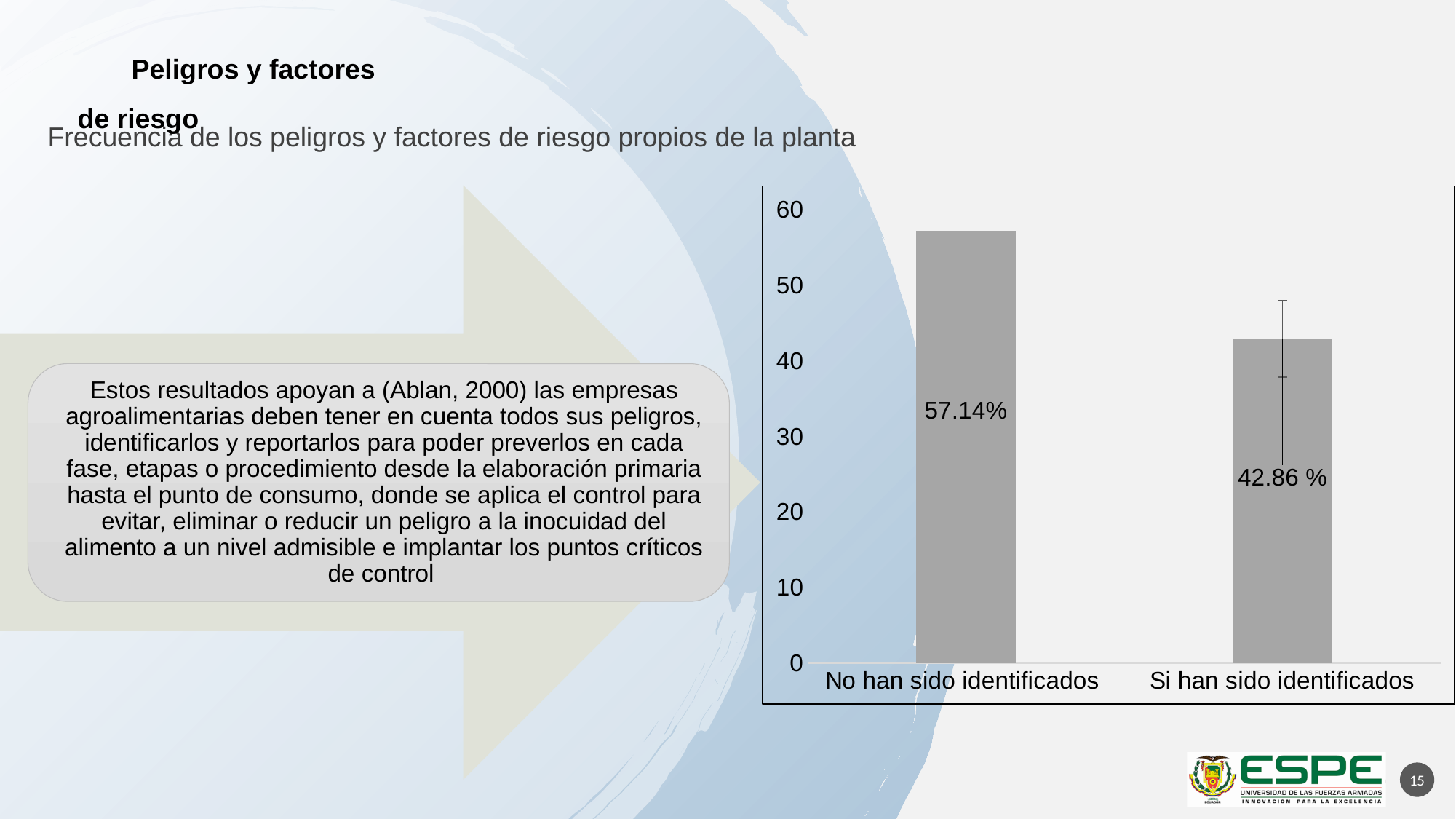
How many categories are shown on the x axis of the chart? 2 What is the highest tick value shown on the vertical axis of the chart? 60 Which category has the lowest value? Si han sido identificados What kind of chart is shown on the slide? Bar chart What is the value shown for "Si han sido identificados"? 42.86 % Which is larger, the value for "No han sido identificados" or the value for "Si han sido identificados"? No han sido identificados Is the value for "Si han sido identificados" greater or less than 50? less What is the title given above the chart on the slide? Frecuencia de los peligros y factores de riesgo propios de la planta Is the value for "No han sido identificados" greater or less than 50? greater What is the value shown for "No han sido identificados"? 57.14% What is the difference between the values for "No han sido identificados" and "Si han sido identificados"? 14.28% Which category has the highest value? No han sido identificados